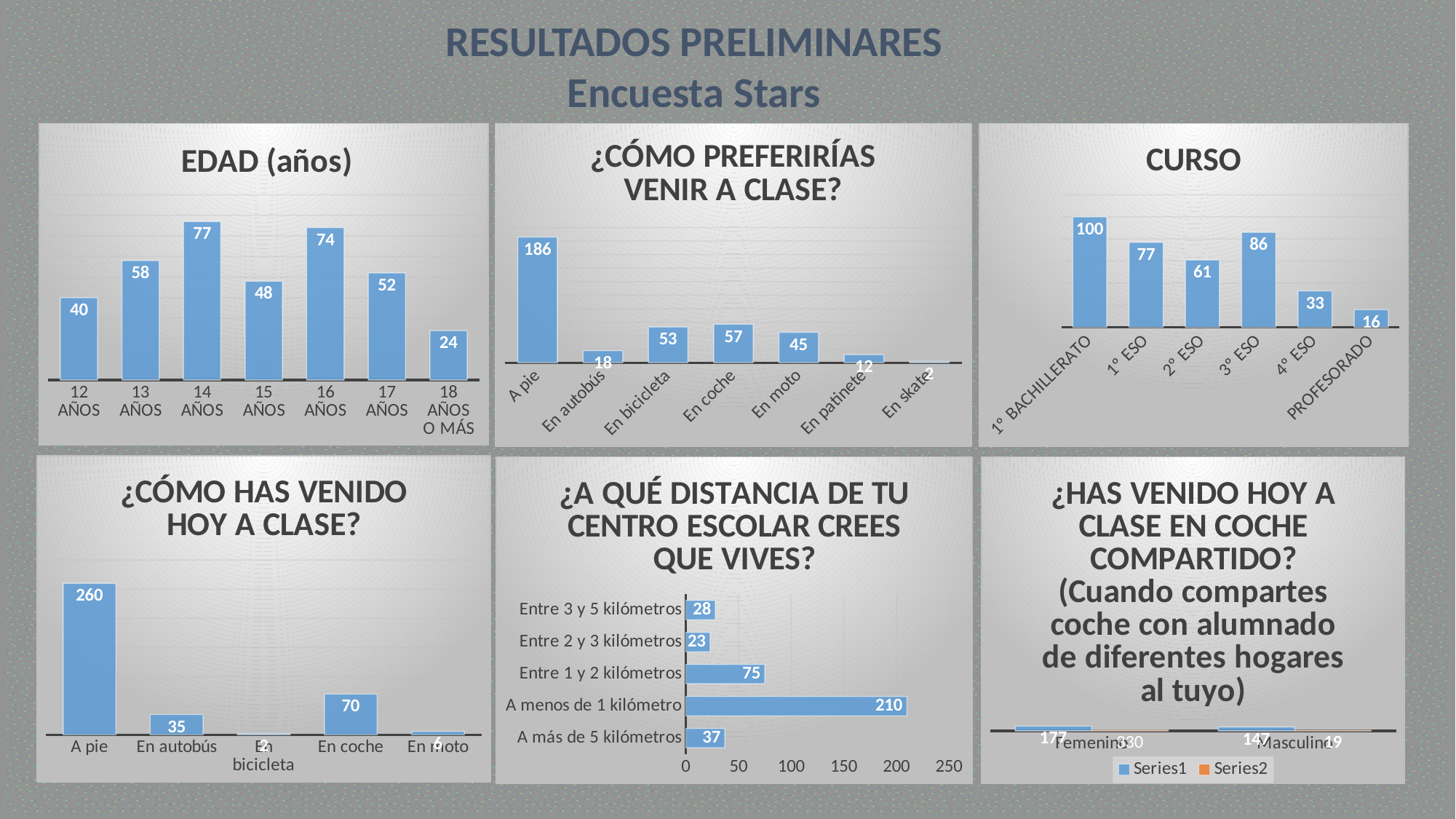
In the '¿CÓMO PREFERIRÍAS VENIR A CLASE?' chart, how many categories are shown? 7 In the 'CURSO' chart, what is the difference between the values for 3º ESO and 2º ESO? 25 In the '¿CÓMO PREFERIRÍAS VENIR A CLASE?' chart, what is the value for 'A pie'? 186 In the 'CURSO' chart, which category has the highest value? 1º BACHILLERATO In the '¿CÓMO HAS VENIDO HOY A CLASE?' chart, which is larger, 'En autobús' or 'En coche'? En coche What kind of chart is the '¿A QUÉ DISTANCIA DE TU CENTRO ESCOLAR CREES QUE VIVES?' chart? Bar chart In the '¿HAS VENIDO HOY A CLASE EN COCHE COMPARTIDO?' chart, how many series does the legend list? 2 In the '¿A QUÉ DISTANCIA DE TU CENTRO ESCOLAR CREES QUE VIVES?' chart, what is the value for 'A menos de 1 kilómetro'? 210 In the 'EDAD (años)' chart, what is the value for 14 AÑOS? 77 In the '¿CÓMO HAS VENIDO HOY A CLASE?' chart, what is the value for 'En coche'? 70 In the 'CURSO' chart, what is the value for PROFESORADO? 16 In the 'EDAD (años)' chart, which age category has the lowest value? 18 AÑOS O MÁS